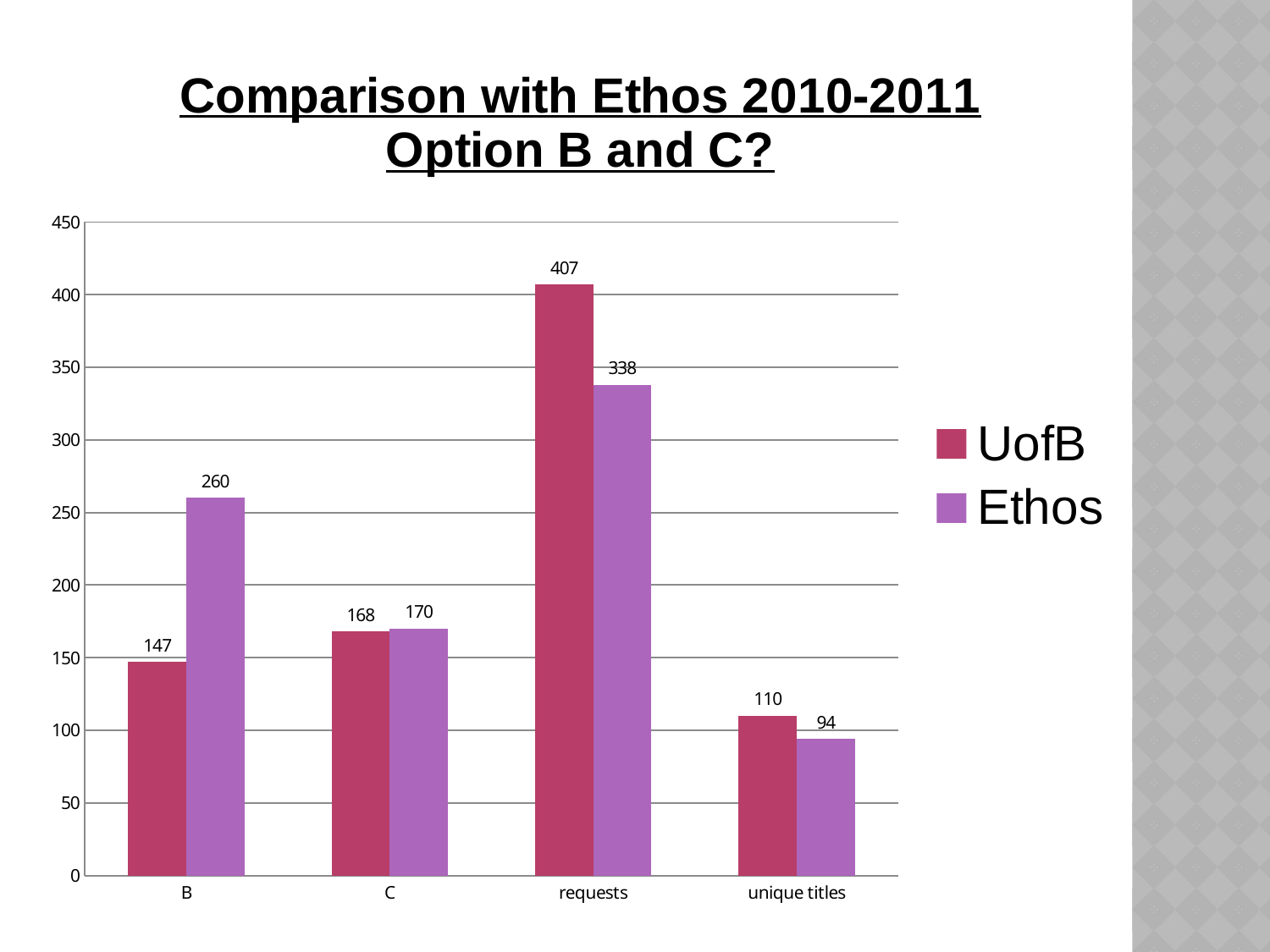
What is the title of the slide? Comparison with Ethos 2010-2011 Option B and C? How many categories are shown on the x axis? 4 What is the Ethos value for B? 260 Which category has the highest UofB value? requests What is the UofB value for requests? 407 What is the Ethos value for unique titles? 94 For unique titles, which series has the larger value, UofB or Ethos? UofB Which category has the lowest Ethos value? unique titles What is the difference between the Ethos and UofB values for B? 113 What kind of chart is shown on the slide? bar chart What is the difference between the UofB and Ethos values for requests? 69 How many series does the legend list? 2